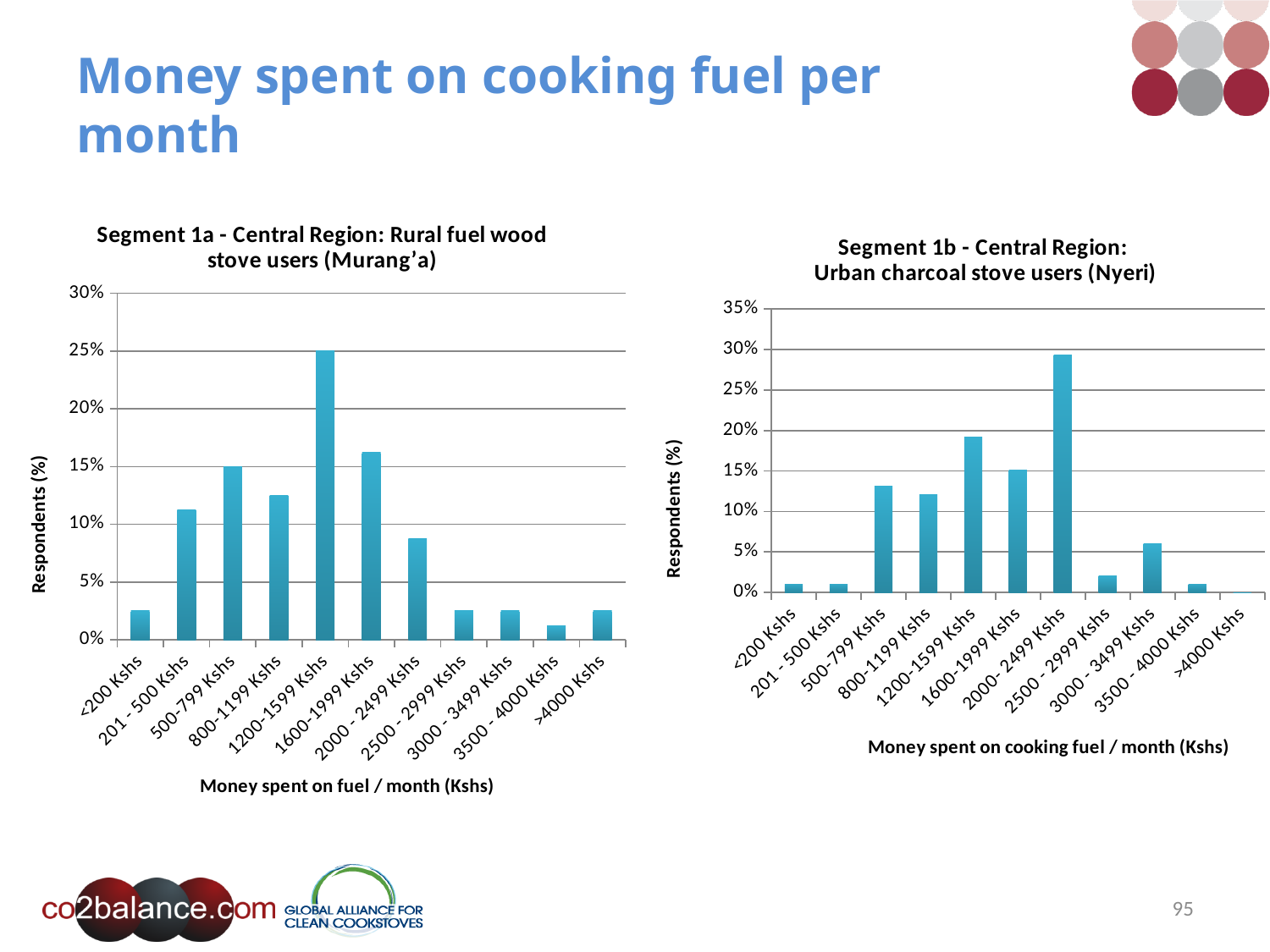
What type of chart is used for Segment 1b (right)? Bar chart In the Segment 1b chart (right), is the value for 1200-1599 Kshs greater or less than 15%? greater In the Segment 1a chart (left), what percentage of respondents spend 500-799 Kshs per month? 15% In the Segment 1b chart (right), which spending category has the highest share of respondents? 2000 - 2499 Kshs In the Segment 1a chart (left), how many spending categories are shown on the x axis? 11 What is the y-axis label of the Segment 1a chart (left)? Respondents (%) In the Segment 1a chart (left), what percentage of respondents spend 1200-1599 Kshs per month? 25% In the Segment 1a chart (left), which spending category has the highest share of respondents? 1200-1599 Kshs In the Segment 1a chart (left), is the value for 1600-1999 Kshs greater or less than 15%? greater In the Segment 1a chart (left), which spending category has the lowest share of respondents? 3500 - 4000 Kshs In the Segment 1b chart (right), is the value for 2000 - 2499 Kshs greater or less than 25%? greater In the Segment 1b chart (right), which is larger: the value for 500-799 Kshs or the value for 3000 - 3499 Kshs? 500-799 Kshs